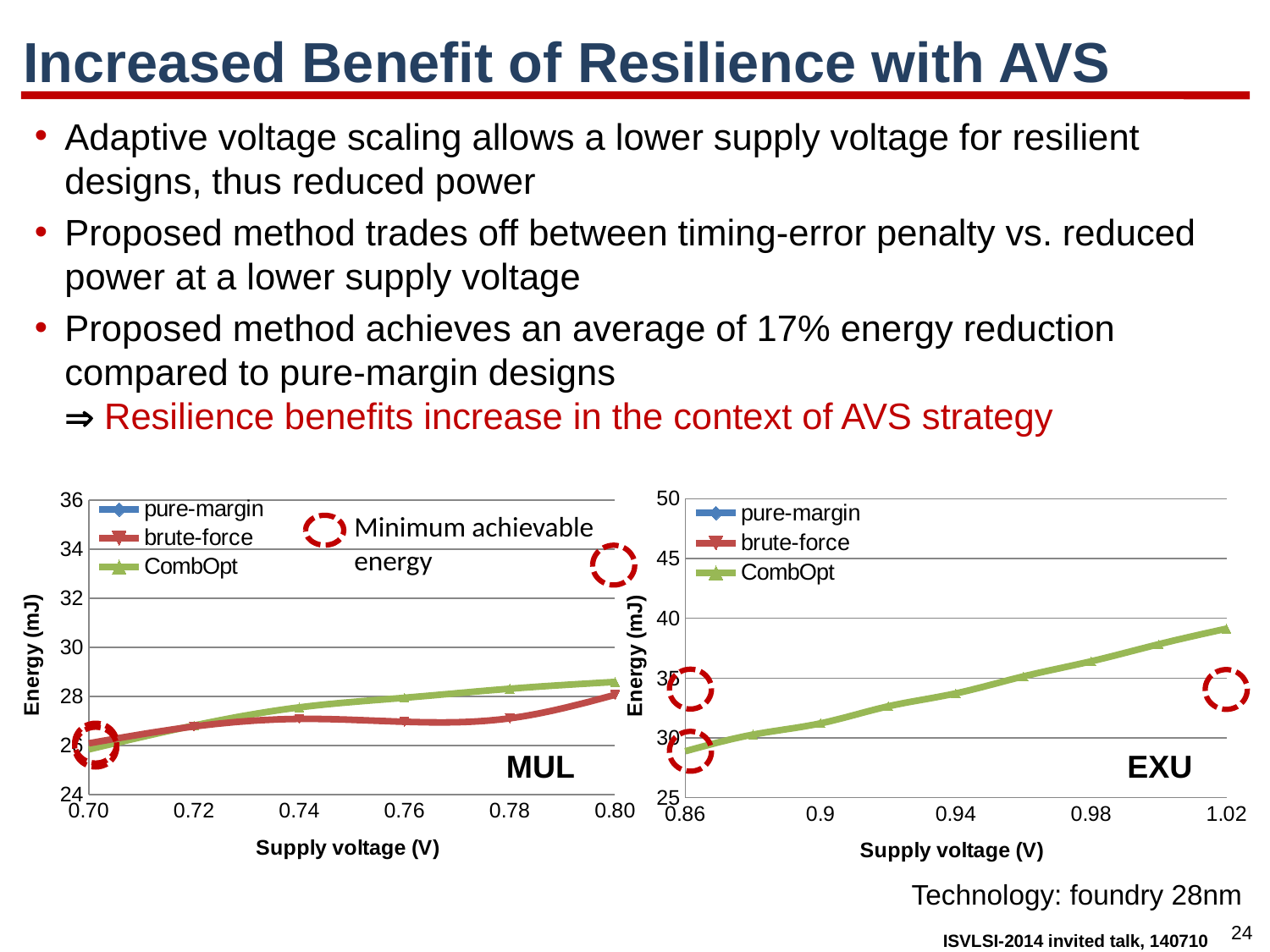
In the MUL chart, is the CombOpt energy at 0.80 V greater or less than 28 mJ? greater What kind of chart is the MUL chart on the left? line chart What is the y-axis label of the MUL chart? Energy (mJ) In the EXU chart, is the CombOpt energy at 1.02 V greater or less than 40 mJ? less How many supply voltage tick labels are shown on the x axis of the EXU chart? 5 In the MUL chart, does the CombOpt energy rise or fall as supply voltage increases from 0.70 to 0.80 V? rise How many series does the legend of the EXU chart list? 3 What is the x-axis label of the EXU chart? Supply voltage (V) In the MUL chart, is the brute-force energy at 0.70 V greater or less than 28 mJ? less In the EXU chart, does the CombOpt energy rise or fall as supply voltage increases from 0.86 to 1.02 V? rise